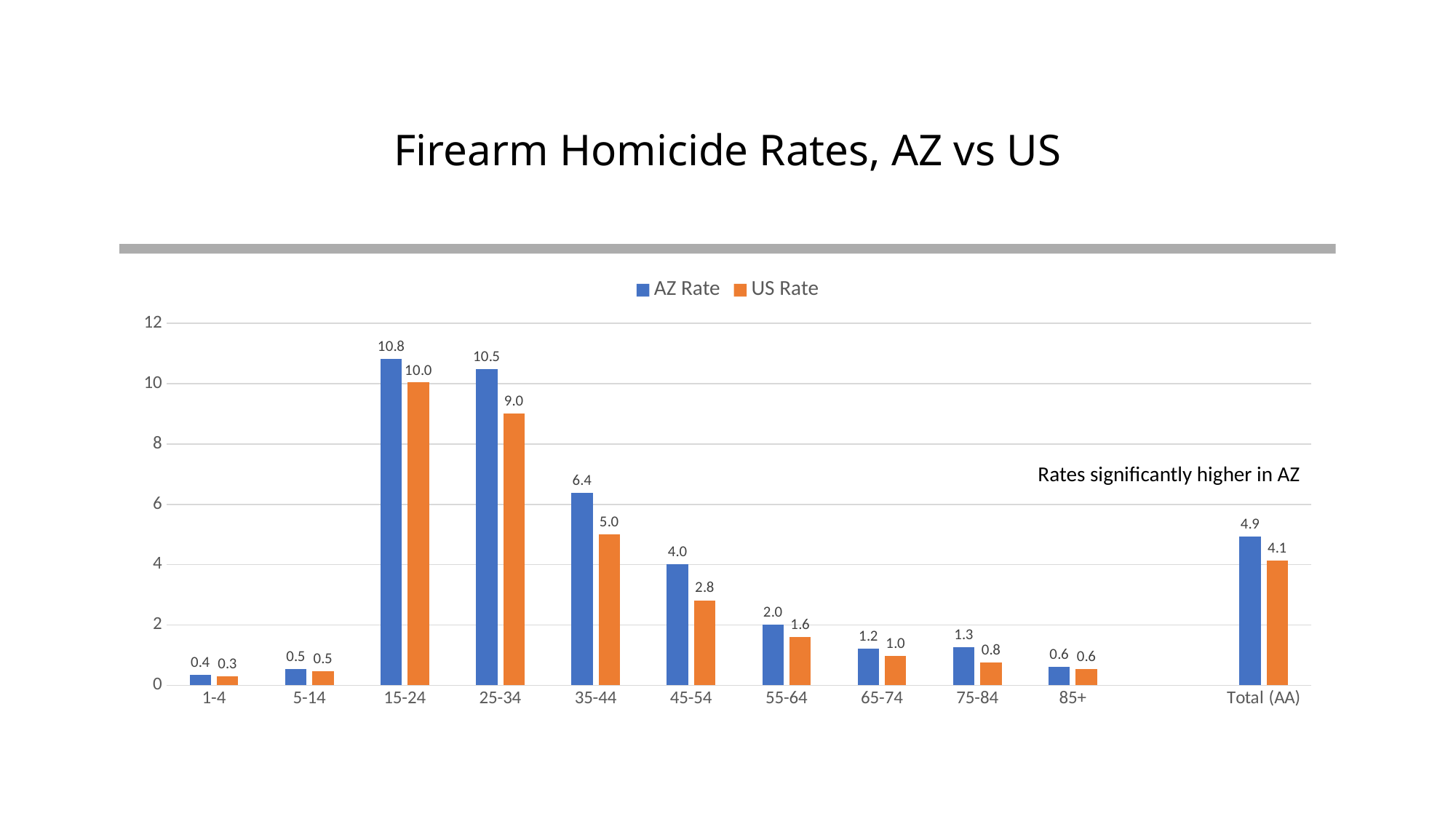
What is the difference between the AZ Rate and the US Rate for the 25-34 age group? 1.5 What is the title of the chart? Firearm Homicide Rates, AZ vs US What kind of chart is shown on the slide? Bar chart What is the AZ Rate for Total (AA)? 4.9 Is the AZ Rate for the 35-44 age group greater or less than 6? greater What is the AZ Rate for the 15-24 age group? 10.8 Which is larger for the 45-54 age group, the AZ Rate or the US Rate? AZ Rate Which age group has the highest AZ Rate? 15-24 What is the US Rate for the 35-44 age group? 5.0 How many categories are shown on the x axis? 11 How many series does the legend list? 2 Which age group has the lowest US Rate? 1-4